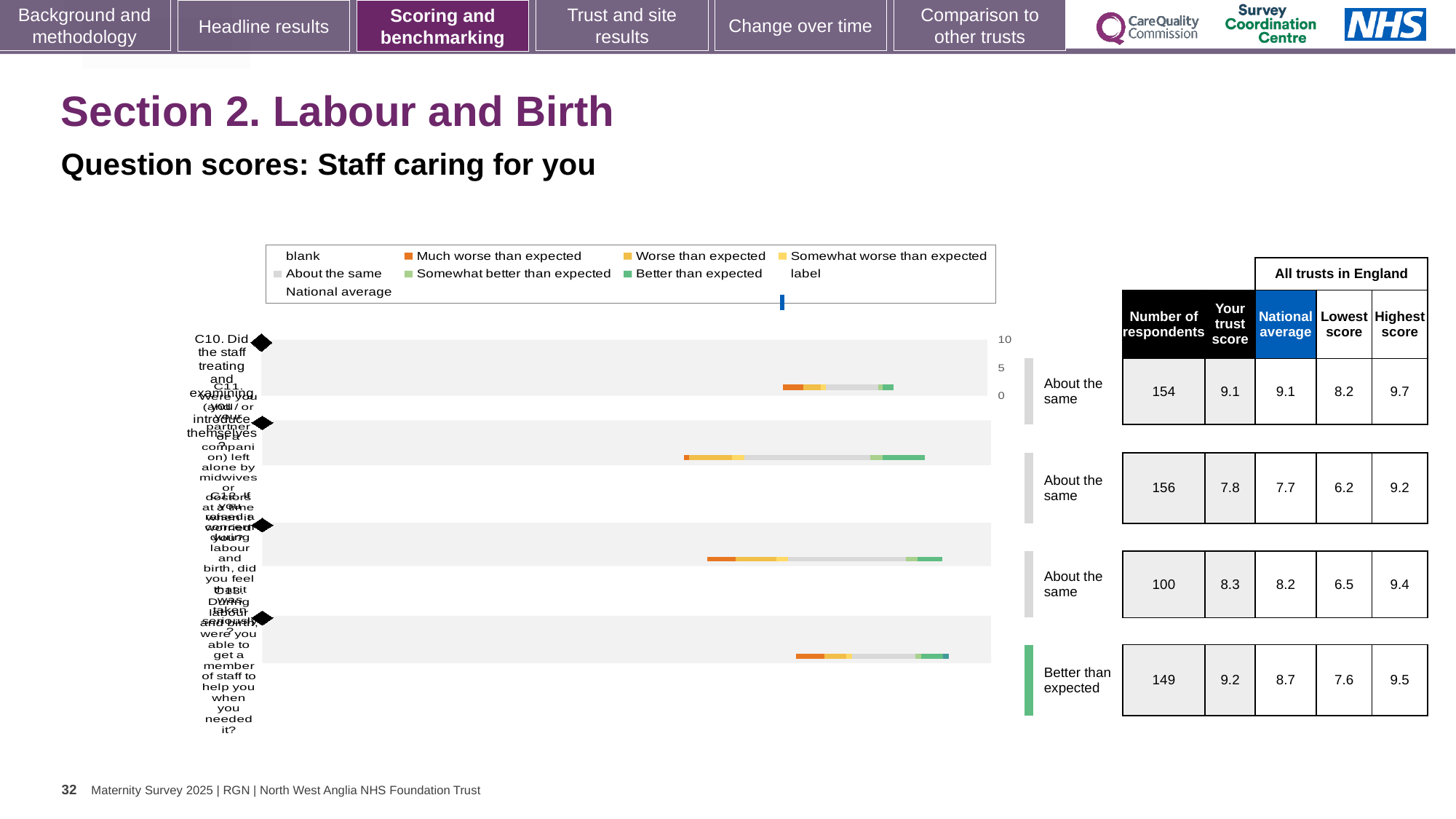
What benchmark label is shown for the fourth (bottom) row? Better than expected Which row has the highest trust score in the table? The fourth (bottom) row, 9.2 How many rows are labelled 'About the same'? 3 For the fourth (bottom) row, is the trust score or the national average larger? Trust score (9.2) In the table, what is the number of respondents for the first (top) row? 154 In the table, what is the trust score for the fourth (bottom) row? 9.2 In the table, what is the highest score for the first (top) row? 9.7 Which row has the smallest value in the Lowest score column? The second row, 6.2 What kind of chart is shown on the slide? Bar chart For the third row, what is the difference between the highest score and the lowest score? 2.9 In the table, what is the national average for the second row? 7.7 How many question rows are plotted in the chart? 4